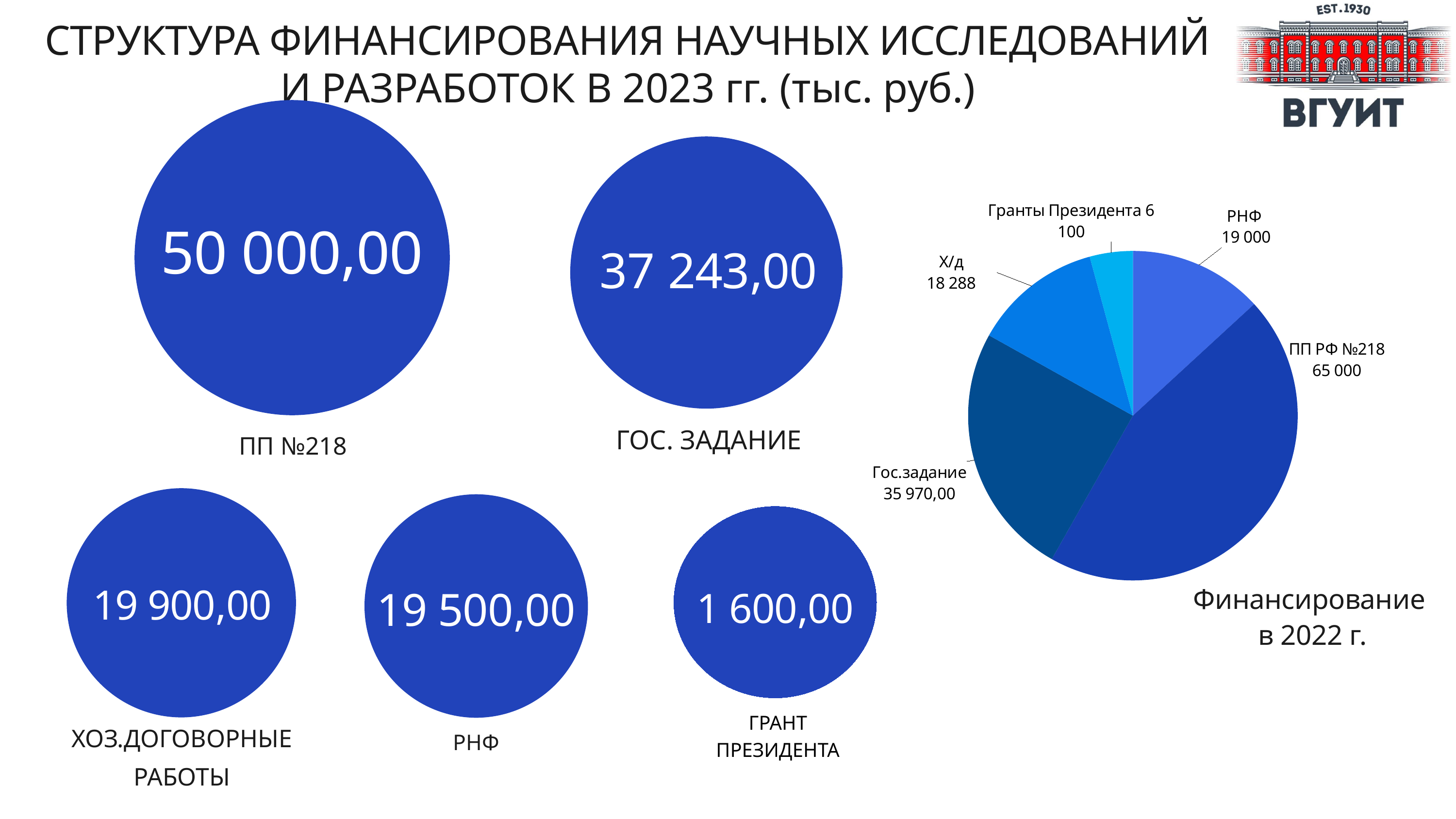
In the pie chart 'Финансирование в 2022 г.', what is the value for РНФ? 19 000 In the pie chart 'Финансирование в 2022 г.', what is the value for Гос.задание? 35 970,00 In the pie chart 'Финансирование в 2022 г.', what is the value for Гранты Президента? 6 100 How many categories (slices) does the pie chart 'Финансирование в 2022 г.' have? 5 What is the title of the chart on the right side of the slide? Финансирование в 2022 г. What kind of chart is shown on the right side of the slide? Pie chart In the pie chart 'Финансирование в 2022 г.', which is larger: the value for РНФ or the value for Х/д? РНФ In the pie chart 'Финансирование в 2022 г.', what is the value for Х/д? 18 288 In the pie chart 'Финансирование в 2022 г.', what is the difference between the values for ПП РФ №218 and Гос.задание? 29 030 In the pie chart 'Финансирование в 2022 г.', which category has the smallest value? Гранты Президента In the pie chart 'Финансирование в 2022 г.', which category has the largest value? ПП РФ №218 In the pie chart 'Финансирование в 2022 г.', what is the value for ПП РФ №218? 65 000